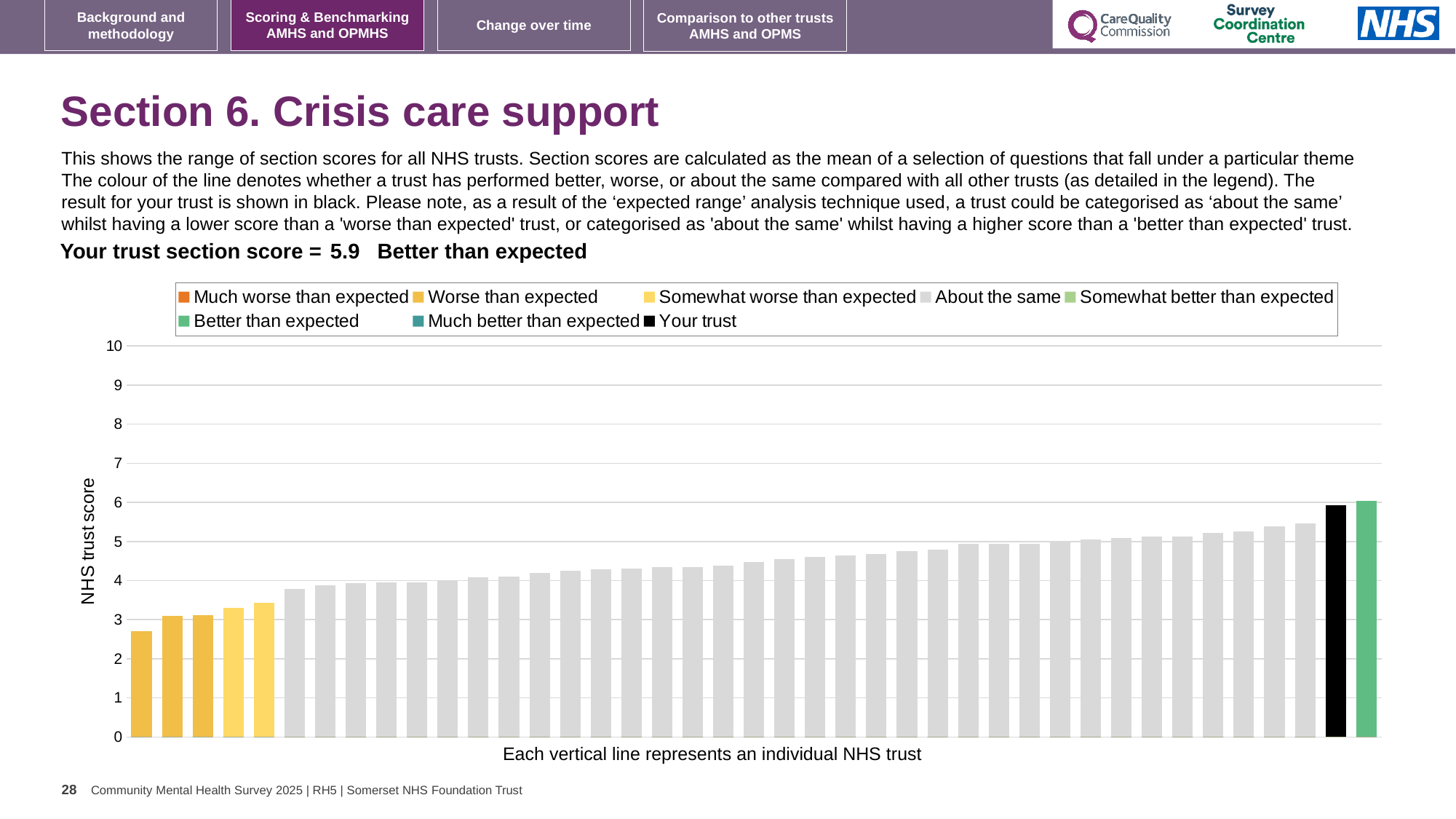
Which category does your trust fall into according to the slide? Better than expected Which is larger: the value for your trust (black bar) or the value of the leftmost bar? your trust How many entries does the chart legend list? 8 Which legend category does the tallest bar belong to? Better than expected What is the label on the vertical axis? NHS trust score What kind of chart is shown on the slide? bar chart Is the value of the rightmost (green) bar greater or less than 5? greater Is the value for your trust (black bar) greater or less than 5? greater Is the value of the leftmost (lowest) bar greater or less than 3? less What is the section score for your trust shown on the slide? 5.9 How many bars are coloured as 'Worse than expected'? 3 Do the bar values rise or fall from left to right along the x axis? rise